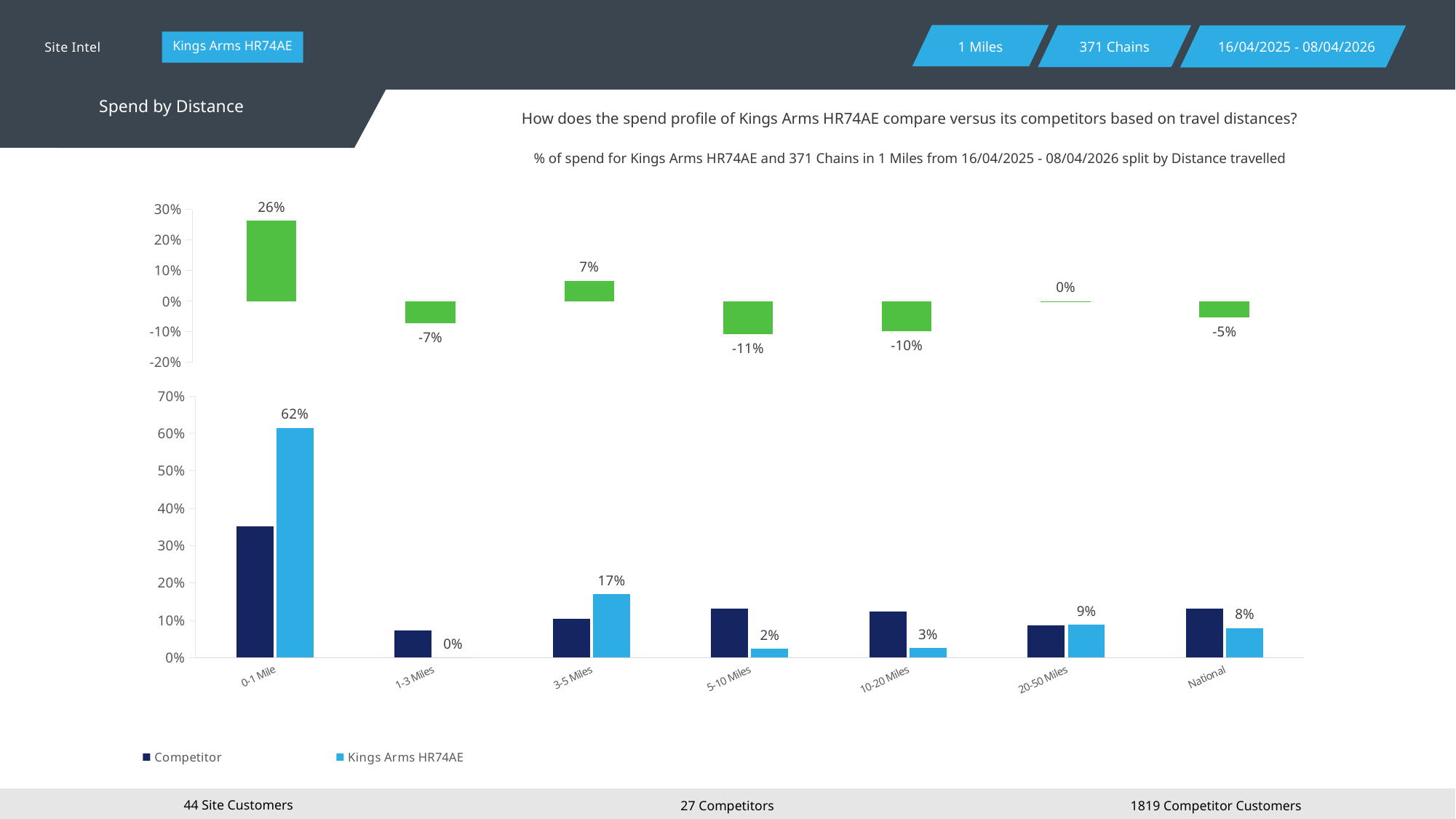
In the bottom chart, what is the value for Kings Arms HR74AE at 3-5 Miles? 17% In the bottom chart, which distance category has the highest Kings Arms HR74AE value? 0-1 Mile In the bottom chart, what is the value for Kings Arms HR74AE at 0-1 Mile? 62% In the top chart, what is the value of the leftmost green bar? 26% In the top chart, what is the lowest value shown? -11% In the bottom chart, which distance category has the lowest Kings Arms HR74AE value? 1-3 Miles In the bottom chart, which is larger at 5-10 Miles, the Competitor value or the Kings Arms HR74AE value? Competitor In the bottom chart, is the Competitor value for 1-3 Miles greater or less than 10%? less How many distance categories are shown on the x axis of the bottom chart? 7 How many series does the legend of the bottom chart list? 2 In the bottom chart, what is the difference between the Kings Arms HR74AE values for 0-1 Mile and 3-5 Miles? 45% In the bottom chart, is the Competitor value for 0-1 Mile greater or less than 30%? greater